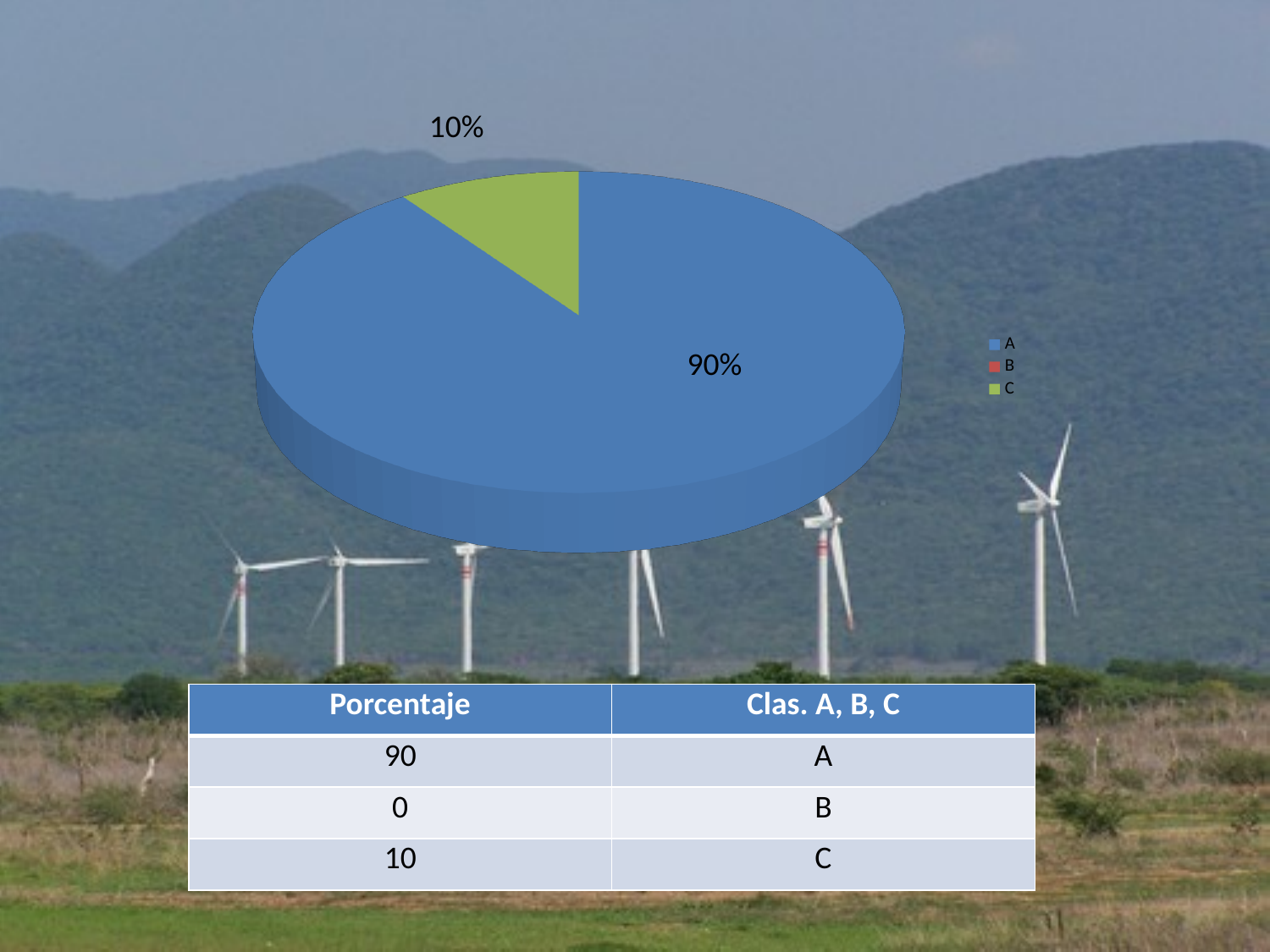
What is the difference in percentage points between slice A and slice C? 80 Which category has the largest slice in the pie chart? A What percentage does slice A represent in the pie chart? 90% How many entries does the legend of the pie chart list? 3 What colour is slice A in the pie chart? blue What percentage does slice C represent in the pie chart? 10% Which is larger in the pie chart, slice A or slice C? A Which category has the smallest visible slice in the pie chart? C What colour is slice C in the pie chart? green According to the table, what is the percentage for category B? 0 Is the value for slice A greater or less than 50%? greater What kind of chart is shown on the slide? pie chart